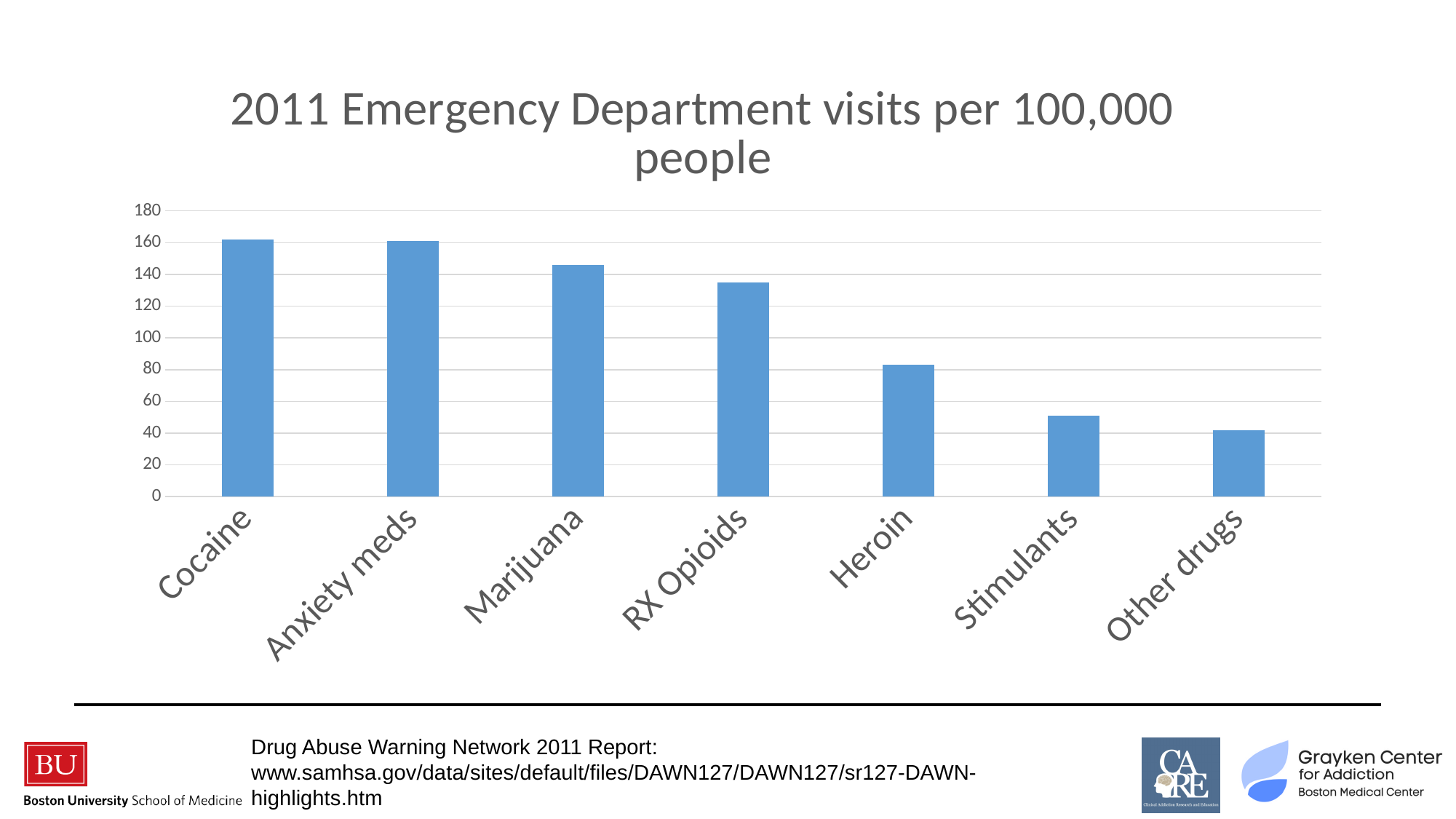
Is the value for Heroin greater or less than 100? less Is the value for Cocaine greater or less than 140? greater Which has more emergency department visits per 100,000 people, Marijuana or RX Opioids? Marijuana Do the bar values rise or fall moving from left to right along the x axis? Fall How many drug categories are shown on the x axis of the chart? 7 Is the value for RX Opioids greater or less than 120? greater Which has more emergency department visits per 100,000 people, Heroin or Stimulants? Heroin What kind of chart is shown on the slide? Bar chart Which category has the lowest number of emergency department visits per 100,000 people? Other drugs